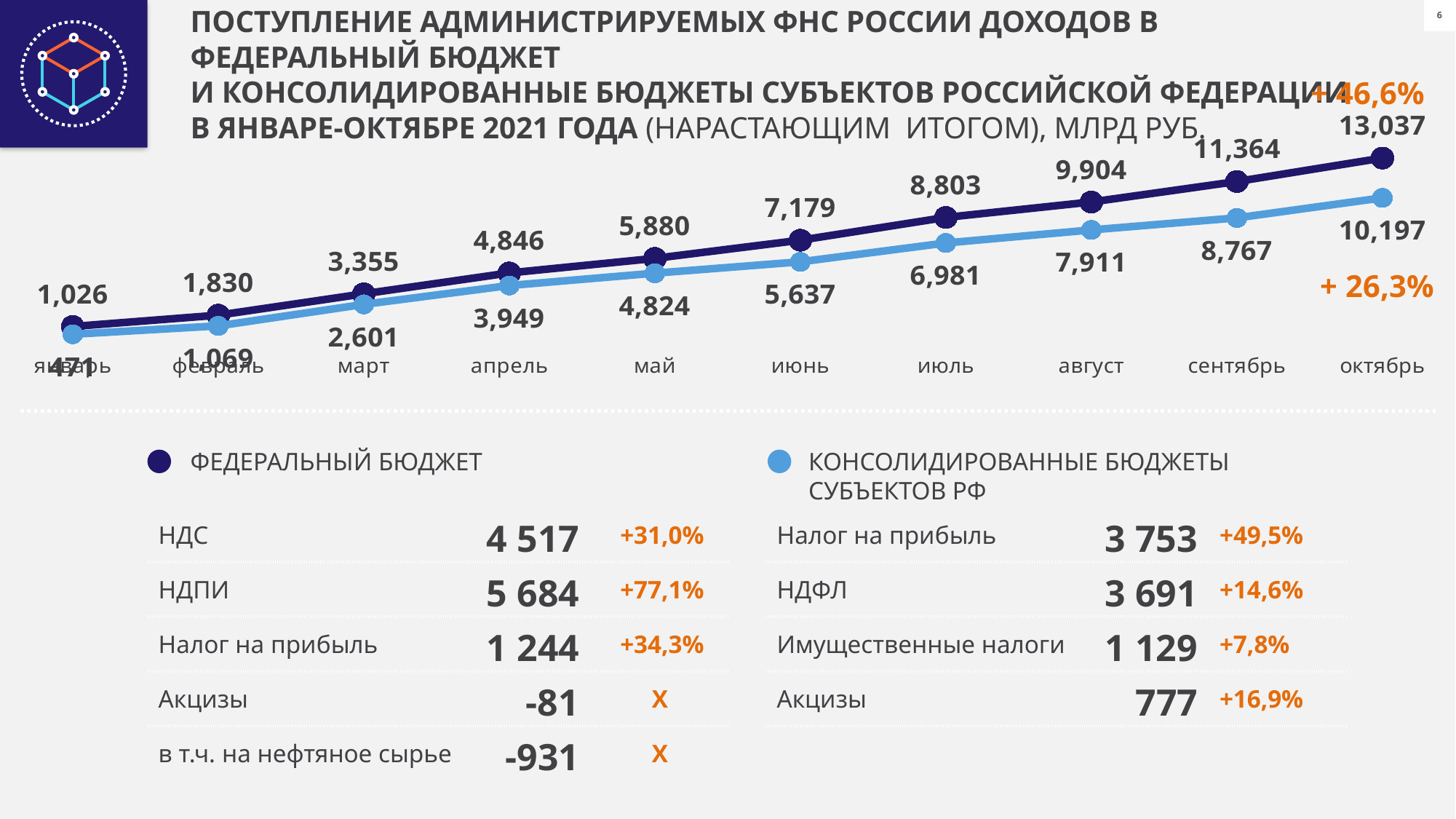
How many months are plotted along the x axis? 10 What is the difference between ФЕДЕРАЛЬНЫЙ БЮДЖЕТ and КОНСОЛИДИРОВАННЫЕ БЮДЖЕТЫ СУБЪЕКТОВ РФ in октябрь? 2,840 What is the value for КОНСОЛИДИРОВАННЫЕ БЮДЖЕТЫ СУБЪЕКТОВ РФ in июль? 6,981 Do the values for ФЕДЕРАЛЬНЫЙ БЮДЖЕТ rise or fall from январь to октябрь? rise What percentage growth is shown next to the ФЕДЕРАЛЬНЫЙ БЮДЖЕТ line at октябрь? +46,6% What is the value for ФЕДЕРАЛЬНЫЙ БЮДЖЕТ in октябрь? 13,037 What type of chart is shown on the slide? line chart In which month does ФЕДЕРАЛЬНЫЙ БЮДЖЕТ reach its highest value? октябрь What is the value for КОНСОЛИДИРОВАННЫЕ БЮДЖЕТЫ СУБЪЕКТОВ РФ in сентябрь? 8,767 Which series has the larger value in август? ФЕДЕРАЛЬНЫЙ БЮДЖЕТ How many series does the legend list? 2 What is the value for ФЕДЕРАЛЬНЫЙ БЮДЖЕТ in май? 5,880